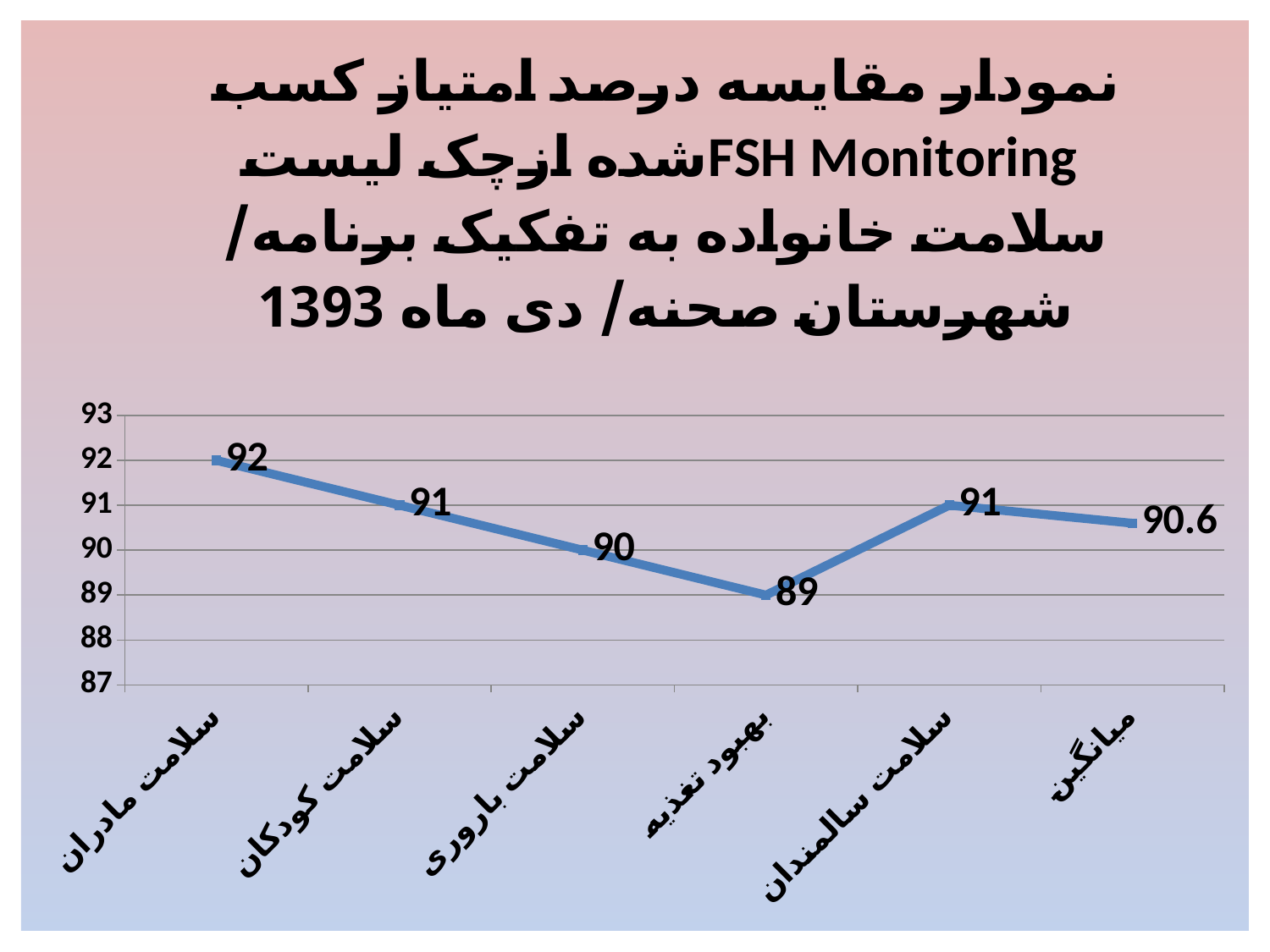
Which is larger, the value for سلامت کودکان or the value for سلامت باروری? سلامت کودکان Which category has the highest value? سلامت مادران Do the values rise or fall from سلامت مادران to بهبود تغذیه? fall What kind of chart is shown on the slide? line chart What is the difference between the values for سلامت مادران and بهبود تغذیه? 3 What is the value for بهبود تغذیه? 89 Which category has the lowest value? بهبود تغذیه What is the value for میانگین? 90.6 What is the value for سلامت مادران? 92 How many categories are plotted on the x axis? 6 What is the lowest value shown on the vertical axis? 87 What is the value for سلامت باروری? 90